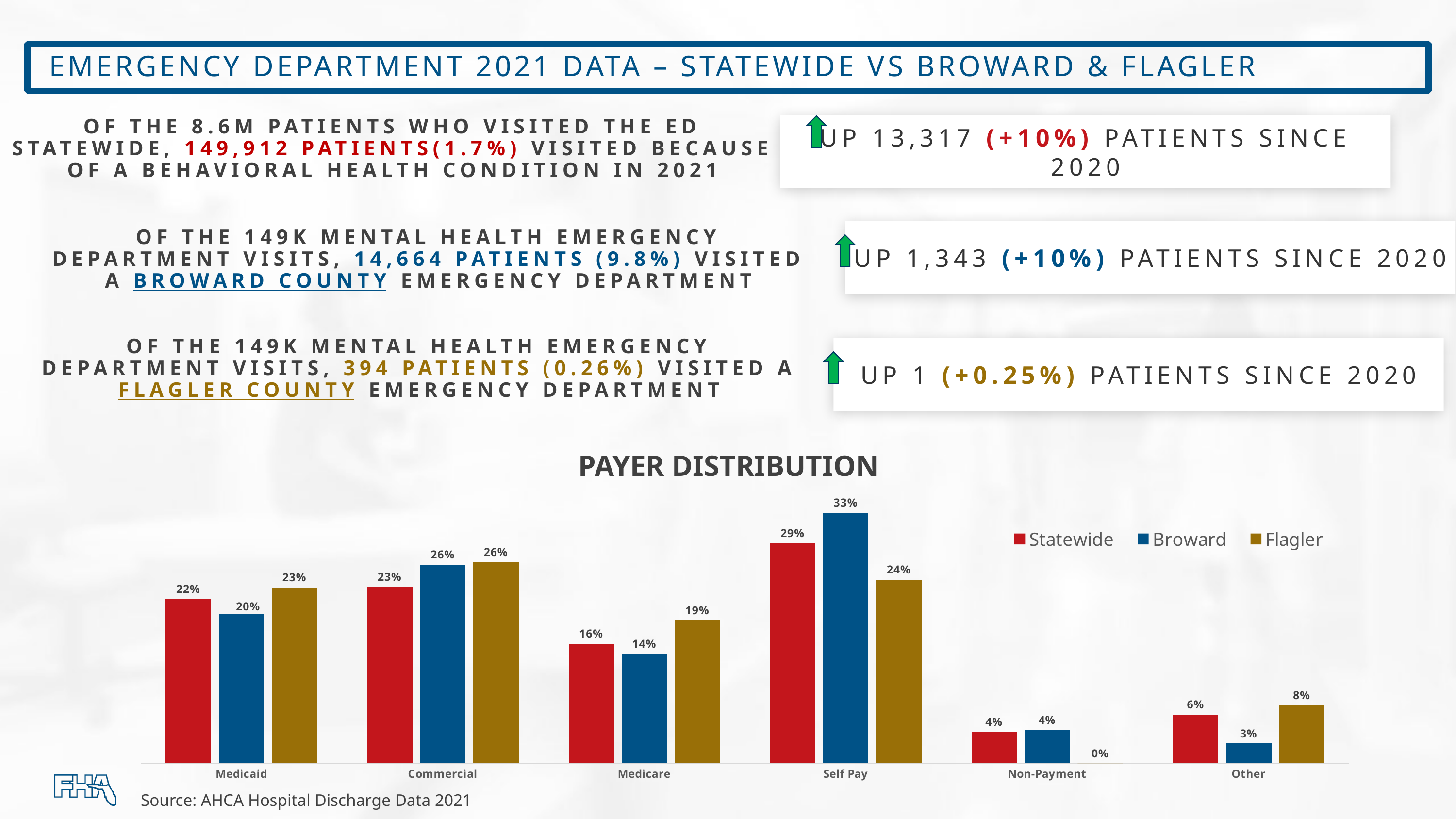
What is the difference between the Flagler and Broward values for Other in the Payer Distribution chart? 5% Which payer category has the lowest Flagler value in the Payer Distribution chart? Non-Payment Which is larger for Medicaid in the Payer Distribution chart: the Statewide value or the Broward value? Statewide Which series is shown in gold in the Payer Distribution chart? Flagler What is the Flagler value for Medicare in the Payer Distribution chart? 19% What is the difference between the Broward and Statewide values for Self Pay in the Payer Distribution chart? 4% How many payer categories are shown on the x axis of the Payer Distribution chart? 6 How many series does the legend of the Payer Distribution chart list? 3 What is the Broward value for Other in the Payer Distribution chart? 3% What is the Statewide value for Self Pay in the Payer Distribution chart? 29% Which payer category has the highest Broward value in the Payer Distribution chart? Self Pay What type of chart is the Payer Distribution chart? Bar chart